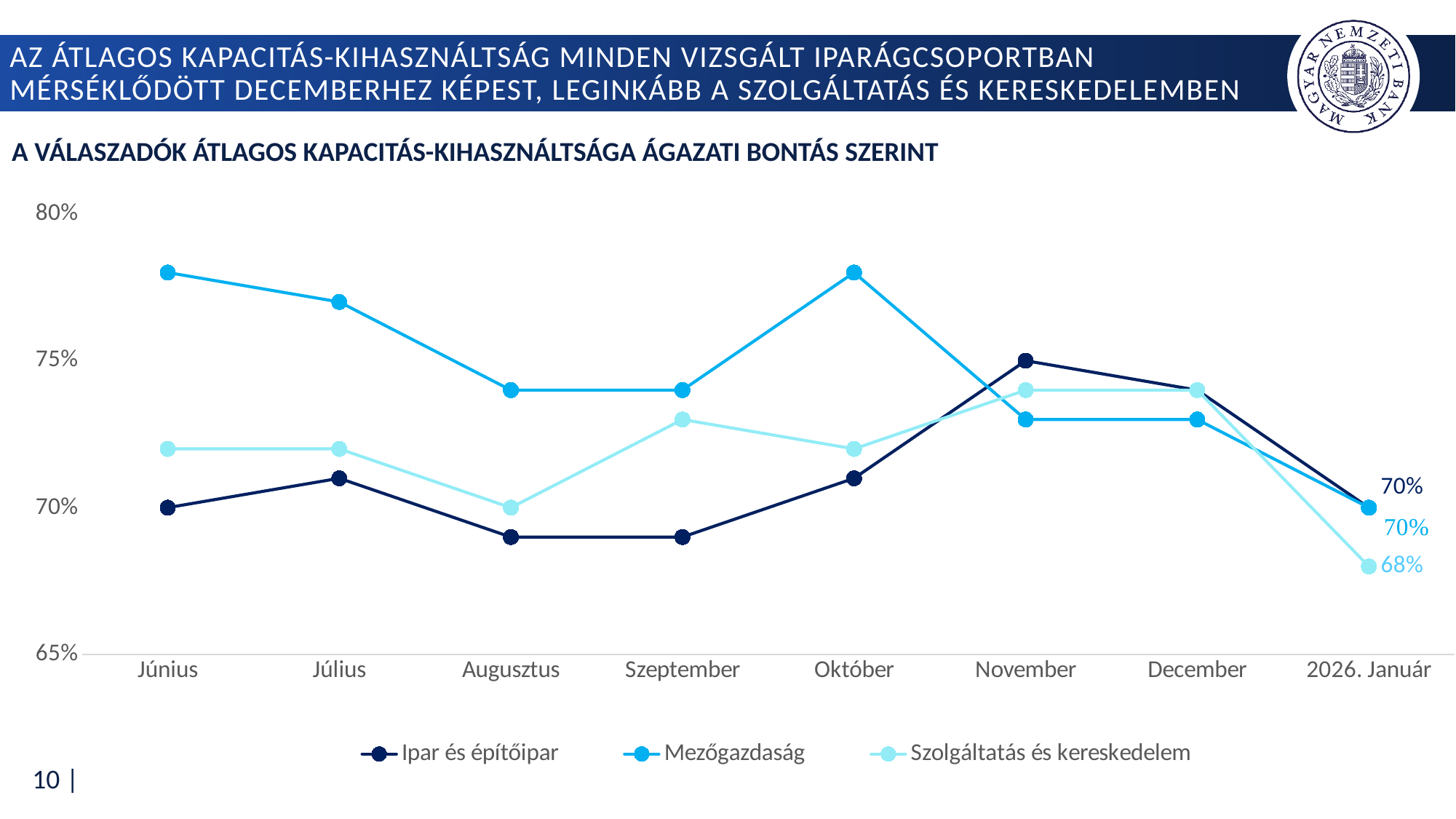
Does the Mezőgazdaság series rise or fall from Június to Augusztus? fall Which series has the lowest value in 2026. Január? Szolgáltatás és kereskedelem What is the value for Szolgáltatás és kereskedelem in 2026. Január? 68% Is the value for Mezőgazdaság in Október greater or less than 75%? greater What is the value for Ipar és építőipar in November? 75% How many months are shown on the x axis? 8 What is the difference between the Ipar és építőipar value and the Szolgáltatás és kereskedelem value in 2026. Január? 2% What type of chart is shown on the slide? line chart How many series does the legend list? 3 What is the value for Mezőgazdaság in 2026. Január? 70% Which series has the highest value in Június? Mezőgazdaság Is the value for Ipar és építőipar in Augusztus greater or less than 70%? less